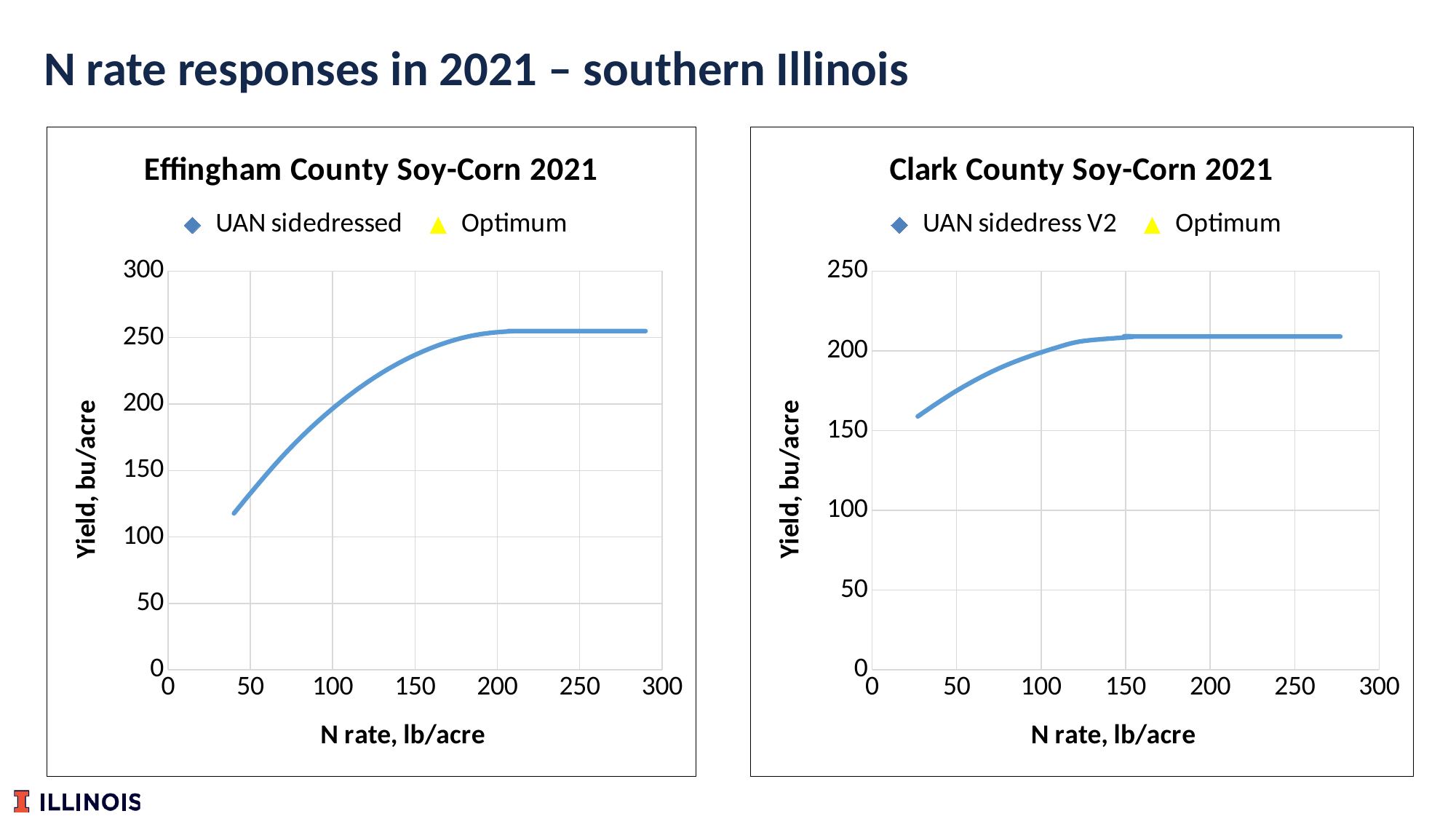
In the Clark County Soy-Corn 2021 chart, does yield rise or fall as N rate increases from 50 to 100 lb/acre? rise In the Clark County Soy-Corn 2021 chart, is the yield at an N rate of 250 lb/acre greater or less than 200 bu/acre? greater In the Effingham County Soy-Corn 2021 chart, is the yield at an N rate of 100 lb/acre greater or less than 150 bu/acre? greater In the Effingham County Soy-Corn 2021 chart, is the yield at an N rate of 250 lb/acre greater or less than 200 bu/acre? greater How many series does the legend of the Clark County Soy-Corn 2021 chart list? 2 What is the name of the first legend entry in the Clark County Soy-Corn 2021 chart? UAN sidedress V2 What kind of chart is the Effingham County Soy-Corn 2021 chart? line chart In the Effingham County Soy-Corn 2021 chart, does yield rise or fall as N rate increases from 50 to 150 lb/acre? rise What is the y-axis title of the Effingham County Soy-Corn 2021 chart? Yield, bu/acre